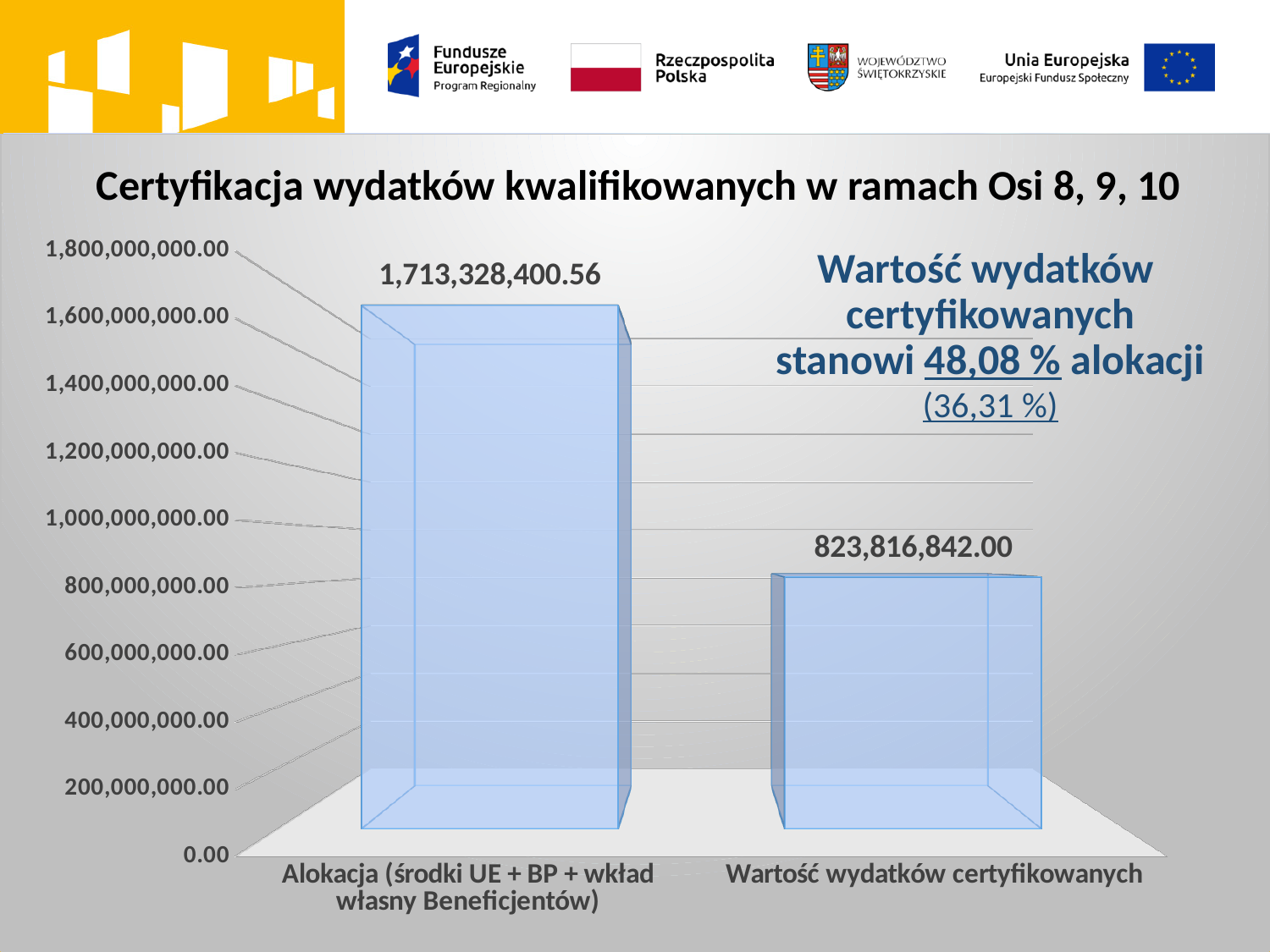
What is the title of the chart on the slide? Certyfikacja wydatków kwalifikowanych w ramach Osi 8, 9, 10 Which category has the highest value? Alokacja (środki UE + BP + wkład własny Beneficjentów) Is the value for 'Alokacja' greater or less than 1,600,000,000.00? greater What kind of chart is shown on the slide? bar chart What is the difference between the 'Alokacja' bar and the 'Wartość wydatków certyfikowanych' bar? 889,511,558.56 Is the value for 'Wartość wydatków certyfikowanych' greater or less than 1,000,000,000.00? less According to the text on the slide, what percentage of the allocation do the certified expenditures represent? 48,08 % Which category has the lowest value? Wartość wydatków certyfikowanych How many categories are shown on the chart? 2 Which is larger: the value for 'Alokacja' or the value for 'Wartość wydatków certyfikowanych'? Alokacja (środki UE + BP + wkład własny Beneficjentów) What is the value of the bar for 'Alokacja (środki UE + BP + wkład własny Beneficjentów)'? 1,713,328,400.56 What is the value of the bar for 'Wartość wydatków certyfikowanych'? 823,816,842.00